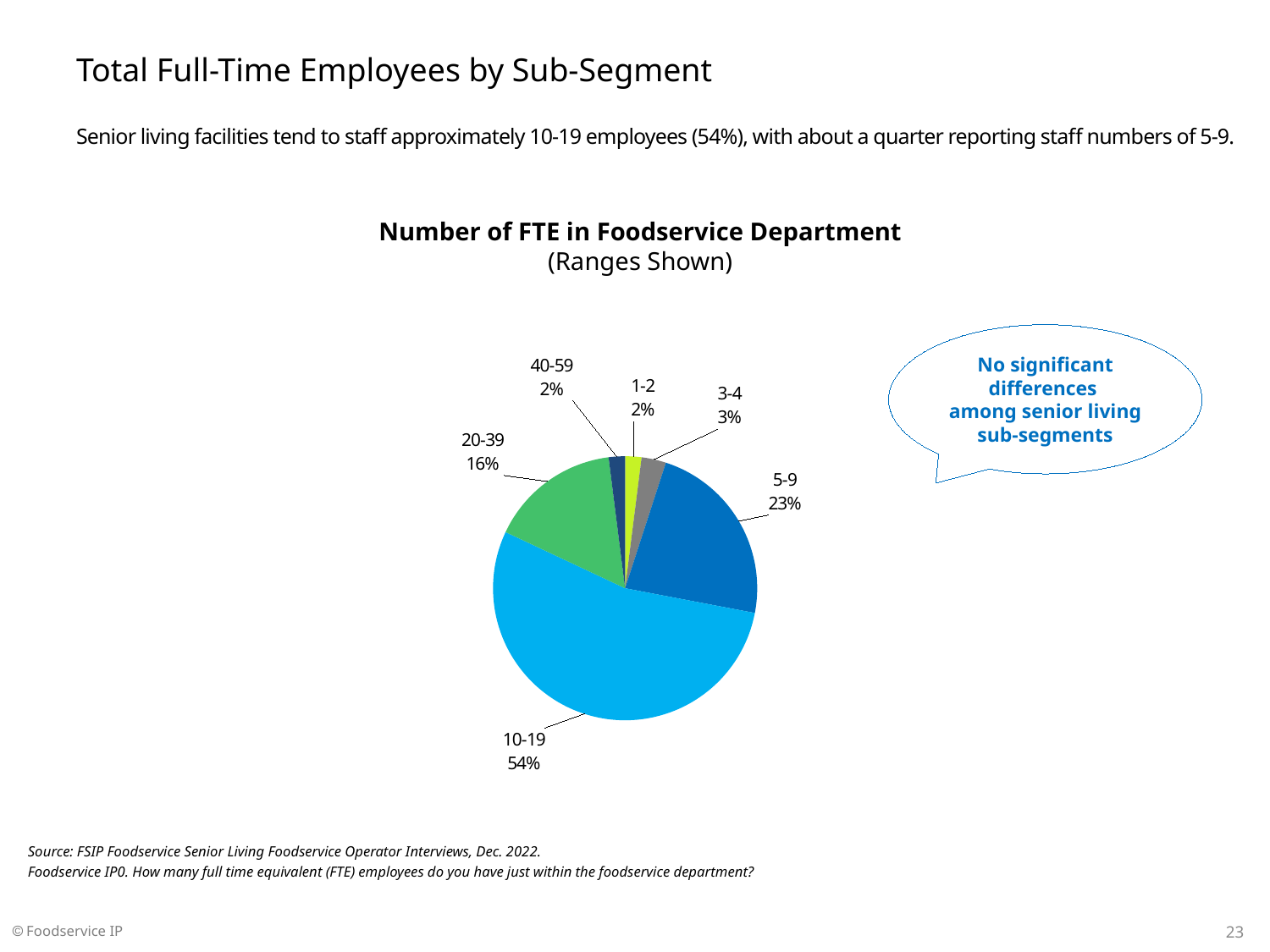
What percentage is shown for the 5-9 range? 23% What percentage is shown for the 3-4 range? 3% What share of the pie does the 10-19 range account for? 54% What is the difference in percentage points between the 10-19 and 5-9 shares? 31 What is the difference in percentage points between the 5-9 and 20-39 shares? 7 What type of chart is shown on the slide? Pie chart Which is larger, the share for 20-39 or the share for 3-4? 20-39 What is the title of the chart? Number of FTE in Foodservice Department (Ranges Shown) Which range has the largest share of the pie? 10-19 How many ranges (slices) are shown in the pie chart? 6 Which range has the largest share after 10-19? 5-9 What percentage is shown for the 20-39 range? 16%